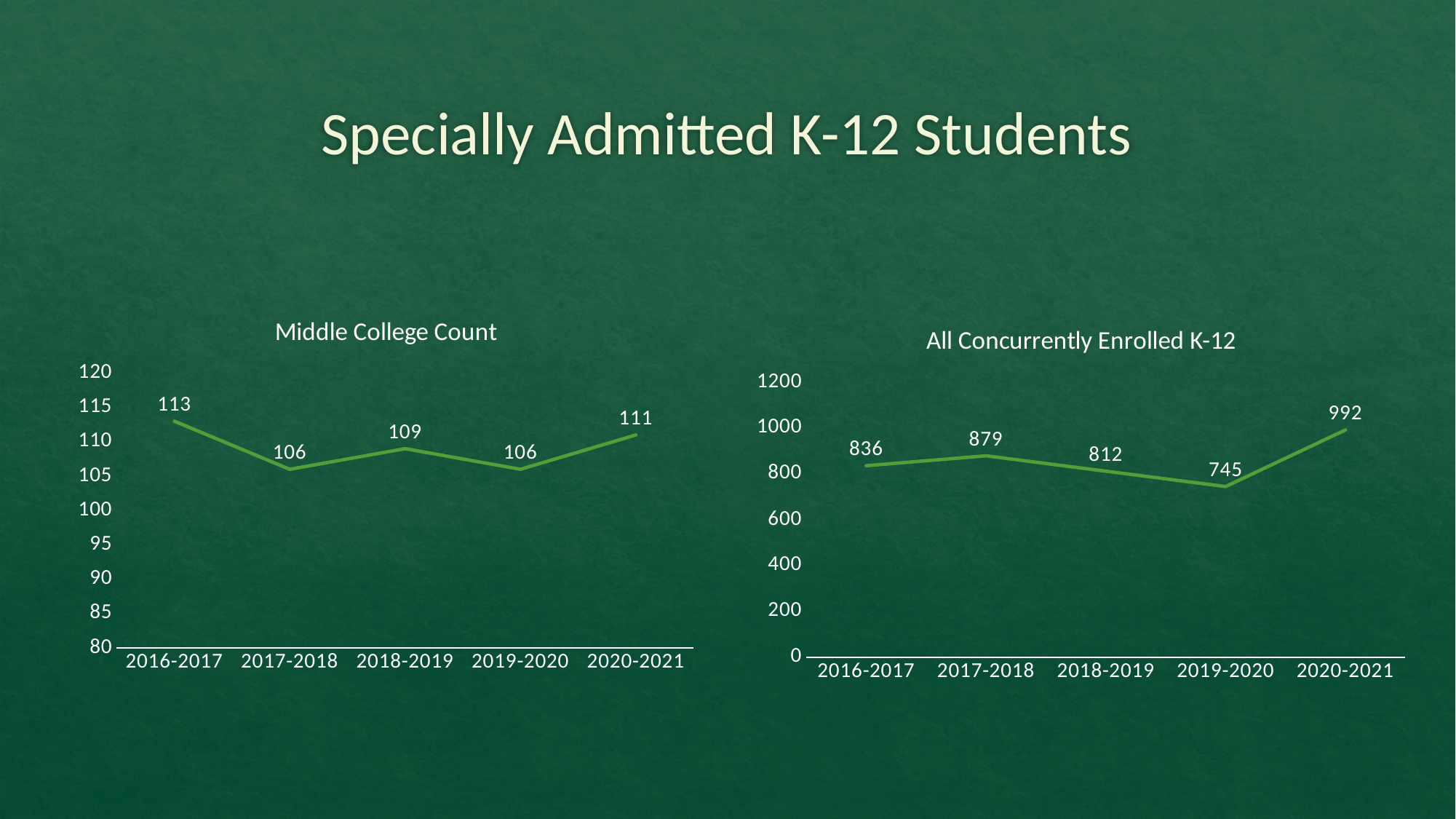
In the Middle College Count chart, what is the difference between the 2016-2017 value and the 2017-2018 value? 7 In the All Concurrently Enrolled K-12 chart, what is the value for 2018-2019? 812 In the All Concurrently Enrolled K-12 chart, is the value for 2017-2018 larger or smaller than the value for 2016-2017? larger In the All Concurrently Enrolled K-12 chart, which year has the lowest value? 2019-2020 In the All Concurrently Enrolled K-12 chart, does the value rise or fall from 2019-2020 to 2020-2021? rise In the Middle College Count chart, which year has the highest value? 2016-2017 What kind of chart is the Middle College Count chart? line chart In the All Concurrently Enrolled K-12 chart, what is the difference between the 2020-2021 value and the 2019-2020 value? 247 In the Middle College Count chart, what is the value for 2016-2017? 113 In the Middle College Count chart, how many data points are plotted? 5 In the All Concurrently Enrolled K-12 chart, which year has the highest value? 2020-2021 In the Middle College Count chart, what is the value for 2020-2021? 111